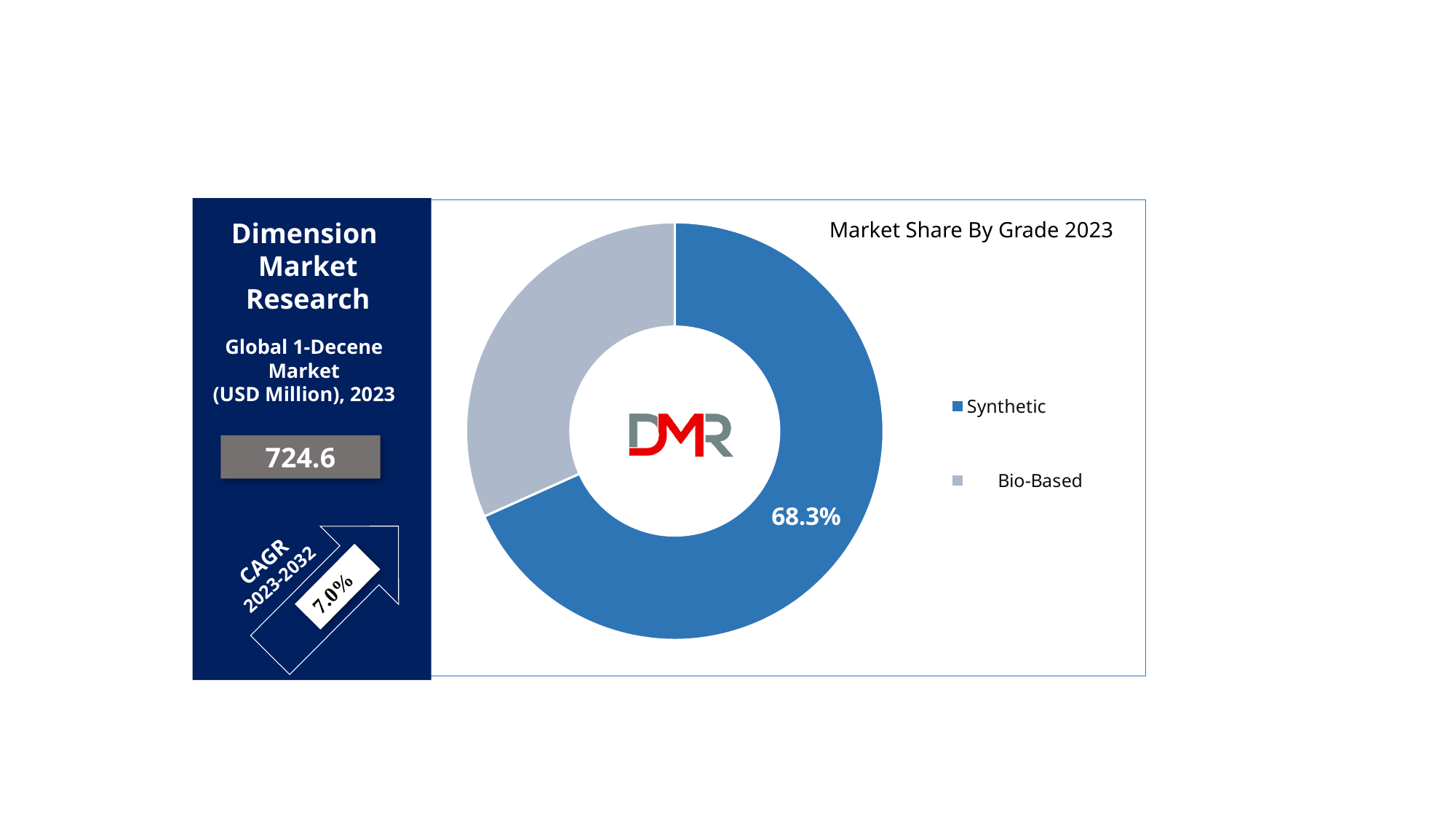
What is the title of the chart on the slide? Market Share By Grade 2023 What kind of chart is used to show Market Share By Grade 2023? Doughnut (pie) chart Which grade has a larger share, Synthetic or Bio-Based? Synthetic Which grade has the largest share in the Market Share By Grade 2023 chart? Synthetic How many grade categories are shown in the doughnut chart? 2 What colour represents the Synthetic grade in the chart? Blue Which grade has the smallest share in the Market Share By Grade 2023 chart? Bio-Based What is the market share of the Synthetic grade in the doughnut chart? 68.3% How many entries does the legend of the chart list? 2